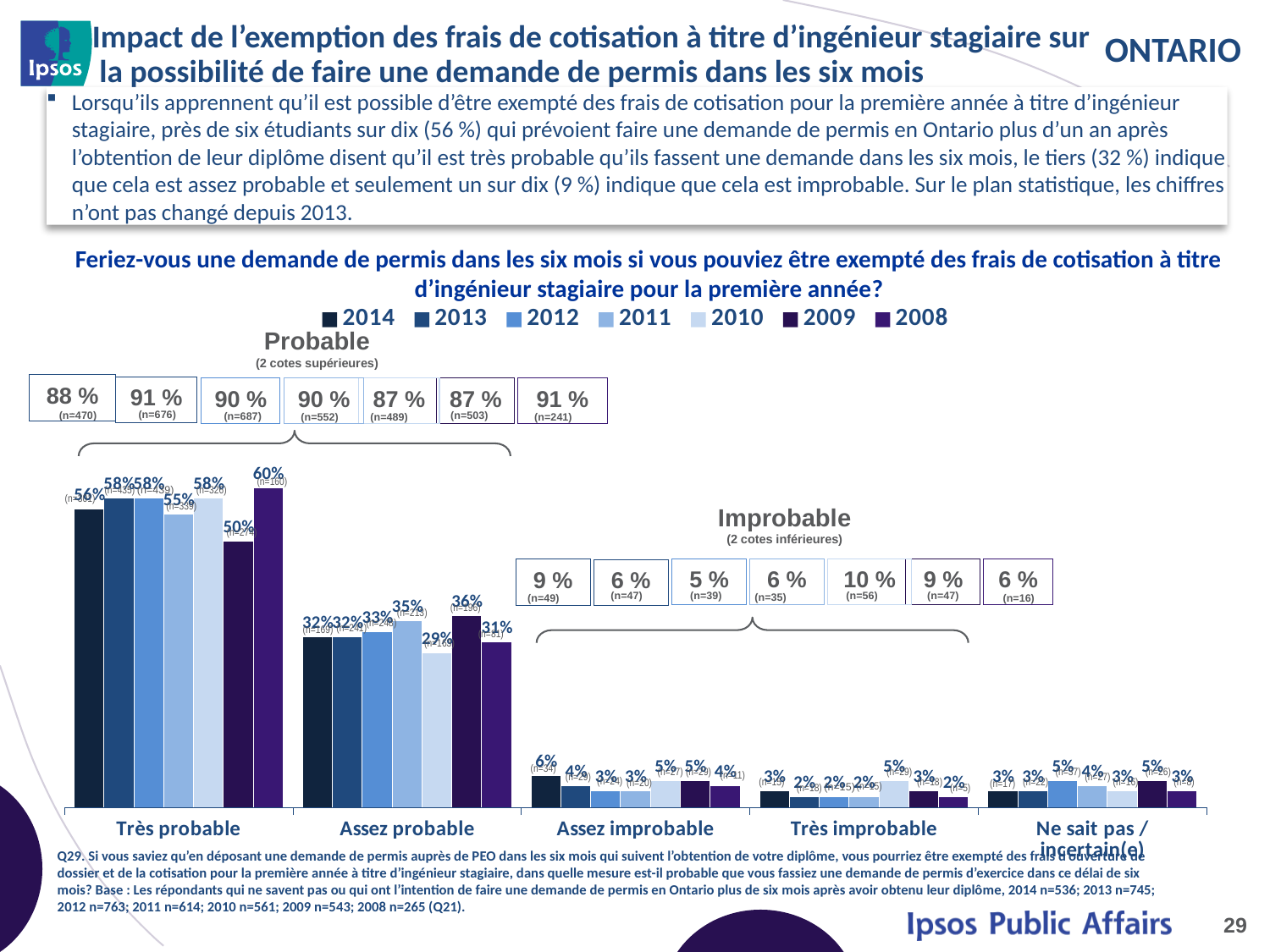
How many response categories are shown along the x axis? 5 Which is larger: the 2011 value for 'Assez probable' or the 2010 value for 'Assez probable'? 2011 Which year has the lowest value in the 'Très probable' category? 2009 What is the value for 2008 in the 'Très probable' category? 60% What type of chart is shown on the slide? bar chart What is the value for 2014 in the 'Très probable' category? 56% How many series does the legend list? 7 Which year has the highest value in the 'Assez probable' category? 2009 What is the value for 2014 in the 'Assez improbable' category? 6% What is the difference between the 2008 and 2009 values in the 'Très probable' category? 10% What 'Probable (2 cotes supérieures)' percentage is shown for 2014? 88 % What is the value for 2009 in the 'Assez probable' category? 36%